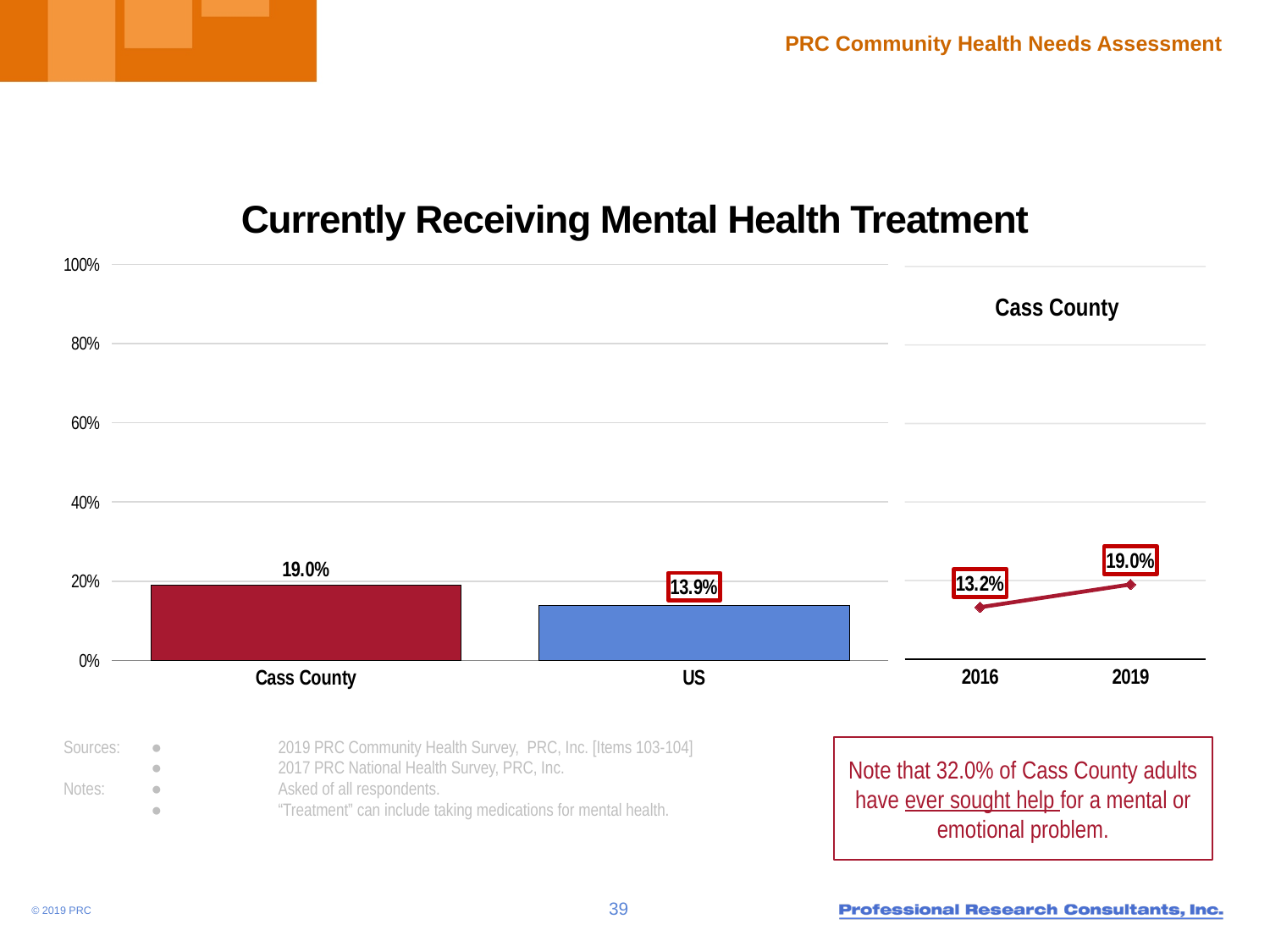
What is the title of the chart on the slide? Currently Receiving Mental Health Treatment In the bar chart on the left, which category has the higher value, Cass County or US? Cass County In the bar chart on the left, what is the value for US? 13.9% In the bar chart on the left, what is the difference between the Cass County value and the US value? 5.1% In the Cass County trend chart on the right, what is the difference between the 2019 value and the 2016 value? 5.8% What kind of chart is the chart on the left? bar chart In the Cass County trend chart on the right, does the value rise or fall from 2016 to 2019? rise In the bar chart on the left, how many categories are shown? 2 What kind of chart is the Cass County chart on the right? line chart In the bar chart on the left, what is the value for Cass County? 19.0% In the Cass County trend chart on the right, what is the value for 2016? 13.2% In the Cass County trend chart on the right, what is the value for 2019? 19.0%